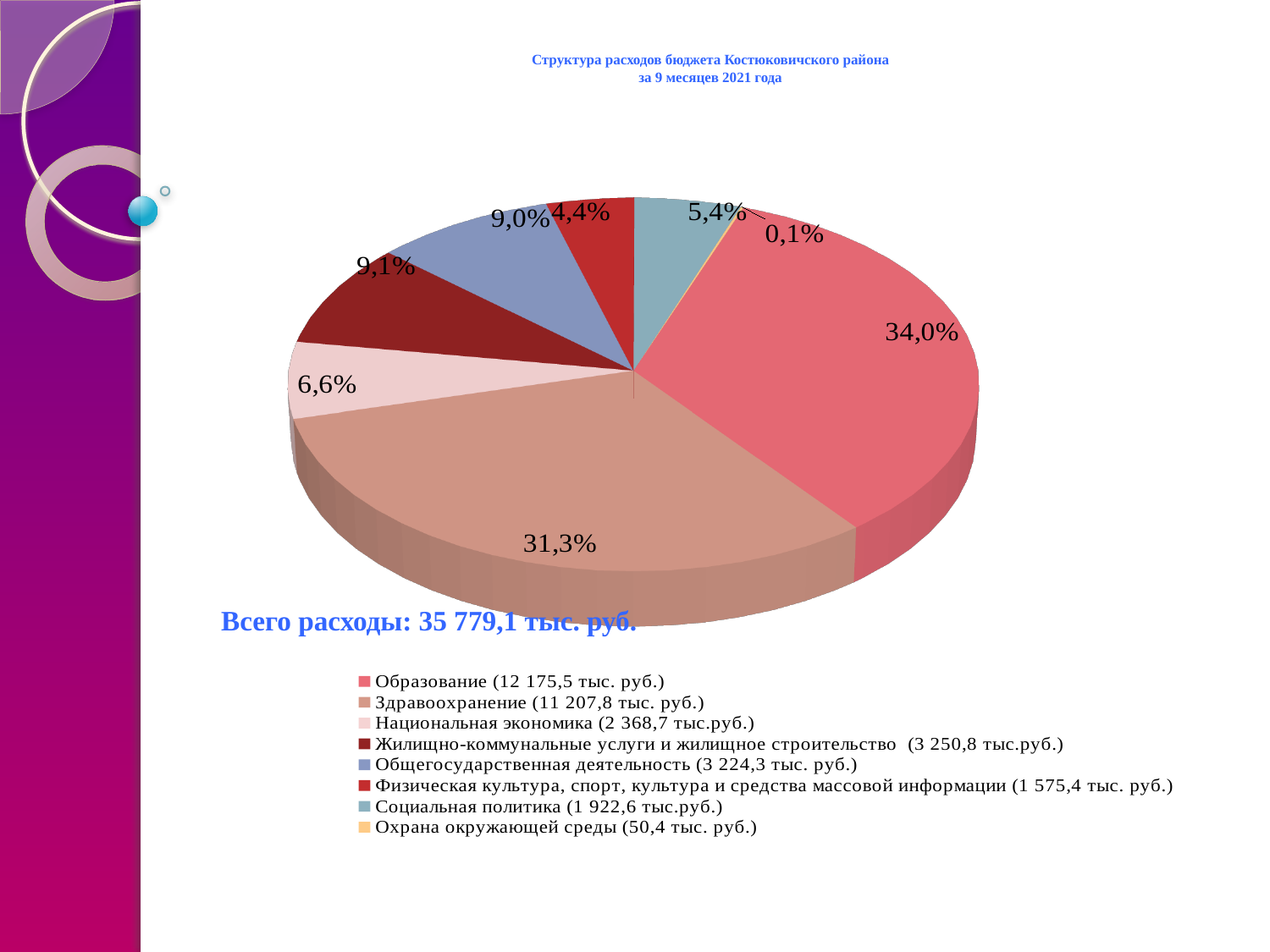
How many categories does the pie chart have? 8 What total expenditure is stated on the slide? 35 779,1 тыс. руб. What share of the pie does Охрана окружающей среды take? 0,1% What share of the pie does Здравоохранение take? 31,3% What share of the pie does Социальная политика take? 5,4% Which category has the largest share of the pie? Образование Which is larger, the share of Национальная экономика or the share of Социальная политика? Национальная экономика Which category has the smallest share of the pie? Охрана окружающей среды What is the difference in percentage points between the shares of Образование and Здравоохранение? 2,7 What amount is given in the legend for Жилищно-коммунальные услуги и жилищное строительство? 3 250,8 тыс.руб. What kind of chart is shown on the slide? pie chart